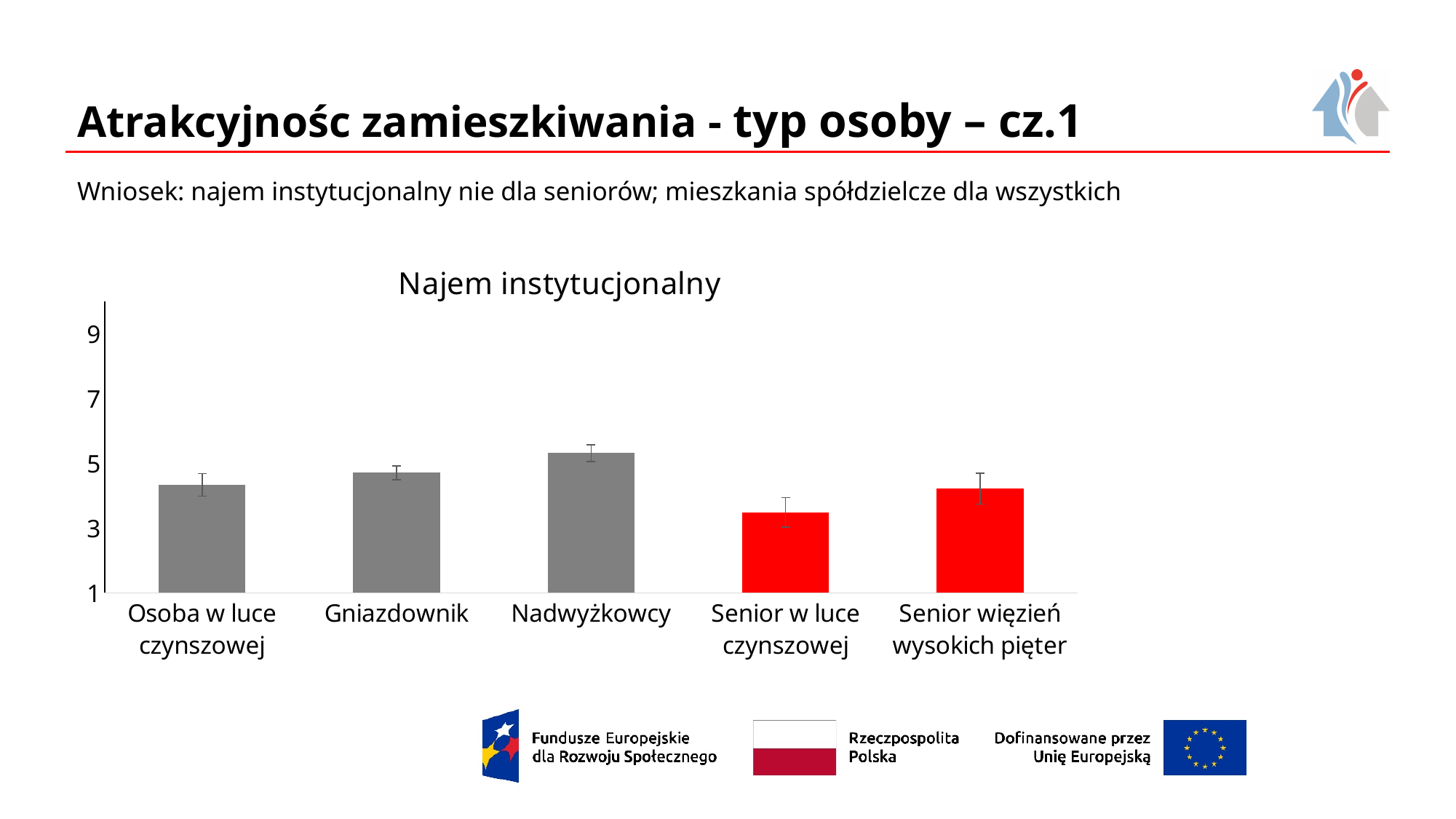
Which category has the highest bar in the chart? Nadwyżkowcy Is the value for Senior w luce czynszowej greater or less than 5? less Is the value for Osoba w luce czynszowej greater or less than 3? greater What kind of chart is shown on the slide? bar chart Which category has the lowest bar in the chart? Senior w luce czynszowej Is the value for Gniazdownik greater or less than 7? less How many categories are shown on the x axis of the chart? 5 Which categories are shown with red bars in the chart? Senior w luce czynszowej and Senior więzień wysokich pięter Which is larger, the value for Gniazdownik or the value for Senior w luce czynszowej? Gniazdownik Which is larger, the value for Nadwyżkowcy or the value for Senior w luce czynszowej? Nadwyżkowcy What is the title of the chart? Najem instytucjonalny